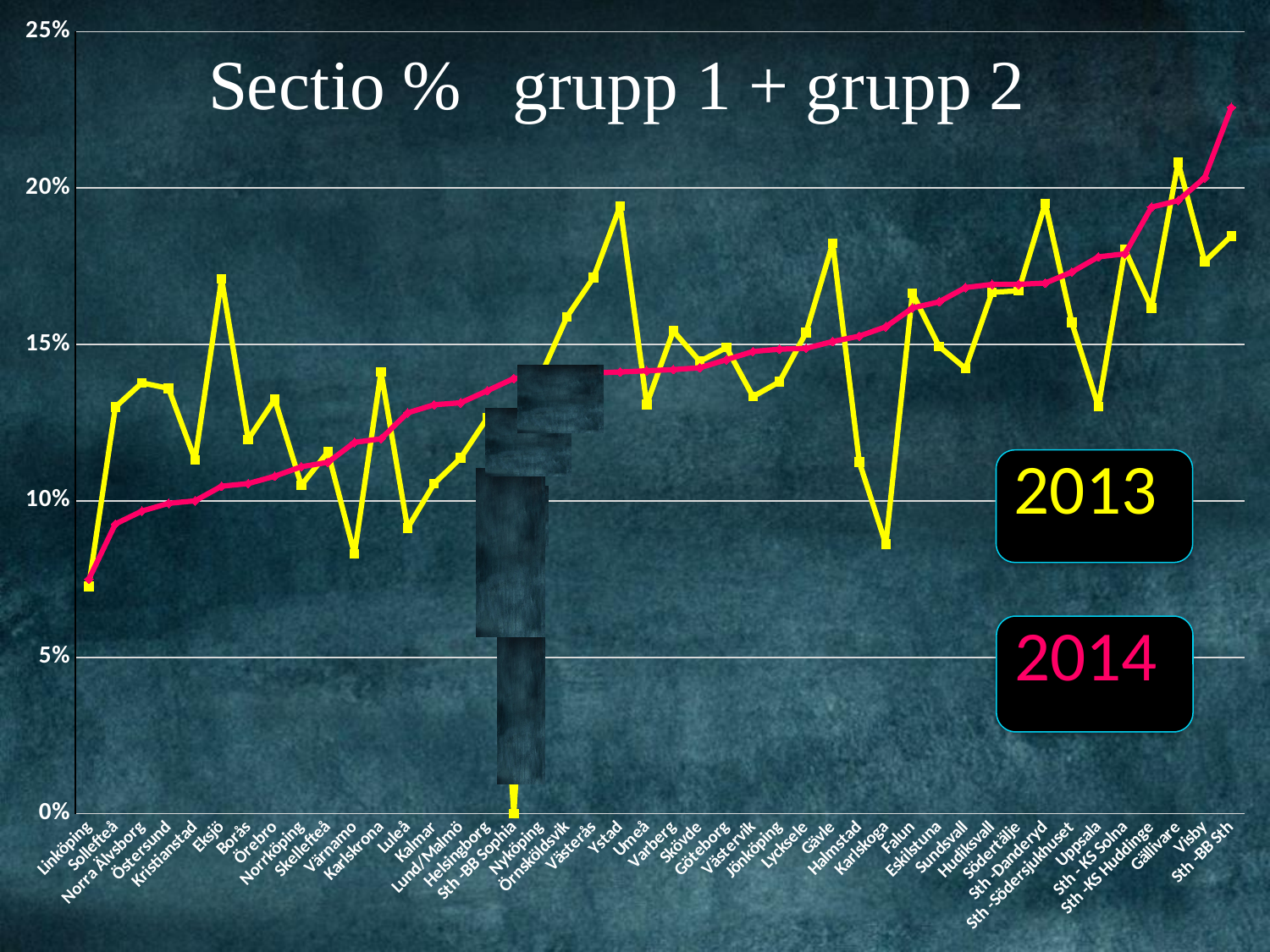
Does the 2014 series generally rise or fall from left to right along the x axis? rise Which hospital has the lowest value in the 2014 series? Linköping What kind of chart is shown on the slide? line chart Is the 2013 value for Ystad greater or less than 15%? greater Which hospital has the highest value in the 2013 series? Gällivare How many series does the legend list? 2 For Karlskoga, which series has the larger value, 2013 or 2014? 2014 Is the 2013 value for Värnamo greater or less than 10%? less What is the title of the chart? Sectio % grupp 1 + grupp 2 Which colour is used for the 2013 series? yellow Is the 2014 value for Sth -BB Sth greater or less than 20%? greater Which hospital has the highest value in the 2014 series? Sth -BB Sth